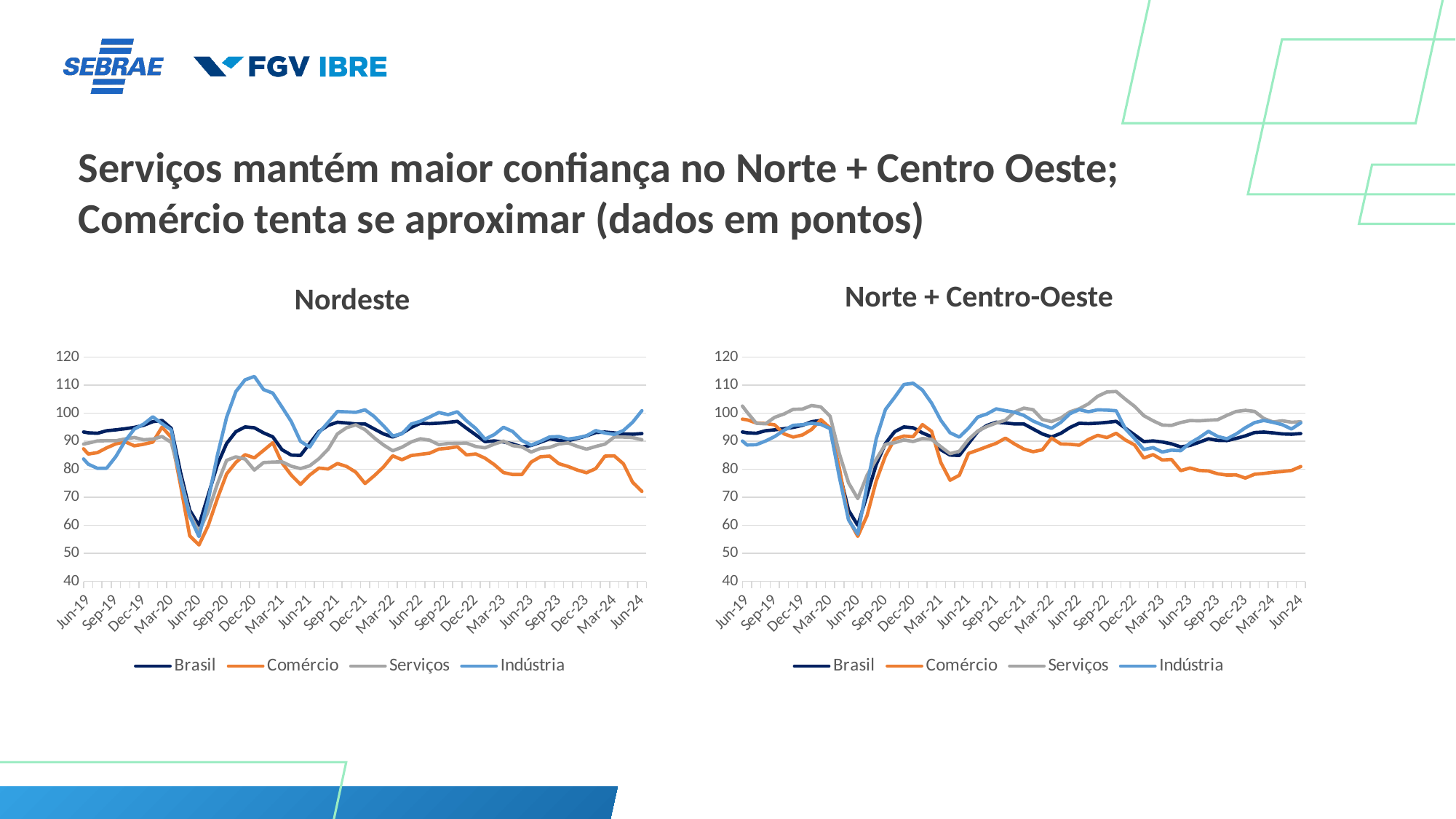
In the Nordeste chart, does the Comércio line rise or fall from Mar-24 to Jun-24? fall In the Norte + Centro-Oeste chart, is the value for Comércio at Jun-20 greater or less than 60? less In the Nordeste chart, which is higher at Jun-24: Indústria or Brasil? Indústria What colour is the Comércio line in the charts? orange In the Nordeste chart, is the value for Comércio at Jun-24 greater or less than 80? less In the Nordeste chart, which series reaches the highest value anywhere on the chart? Indústria How many series does the legend of the Norte + Centro-Oeste chart list? 4 In the Nordeste chart, is the value for Indústria at Dec-20 greater or less than 100? greater What are the titles of the two charts on the slide? Nordeste; Norte + Centro-Oeste In the Norte + Centro-Oeste chart, which is higher at Jun-24: Serviços or Comércio? Serviços In the Nordeste chart, which series has the lowest value at Jun-24? Comércio What kind of chart is the Nordeste chart? line chart